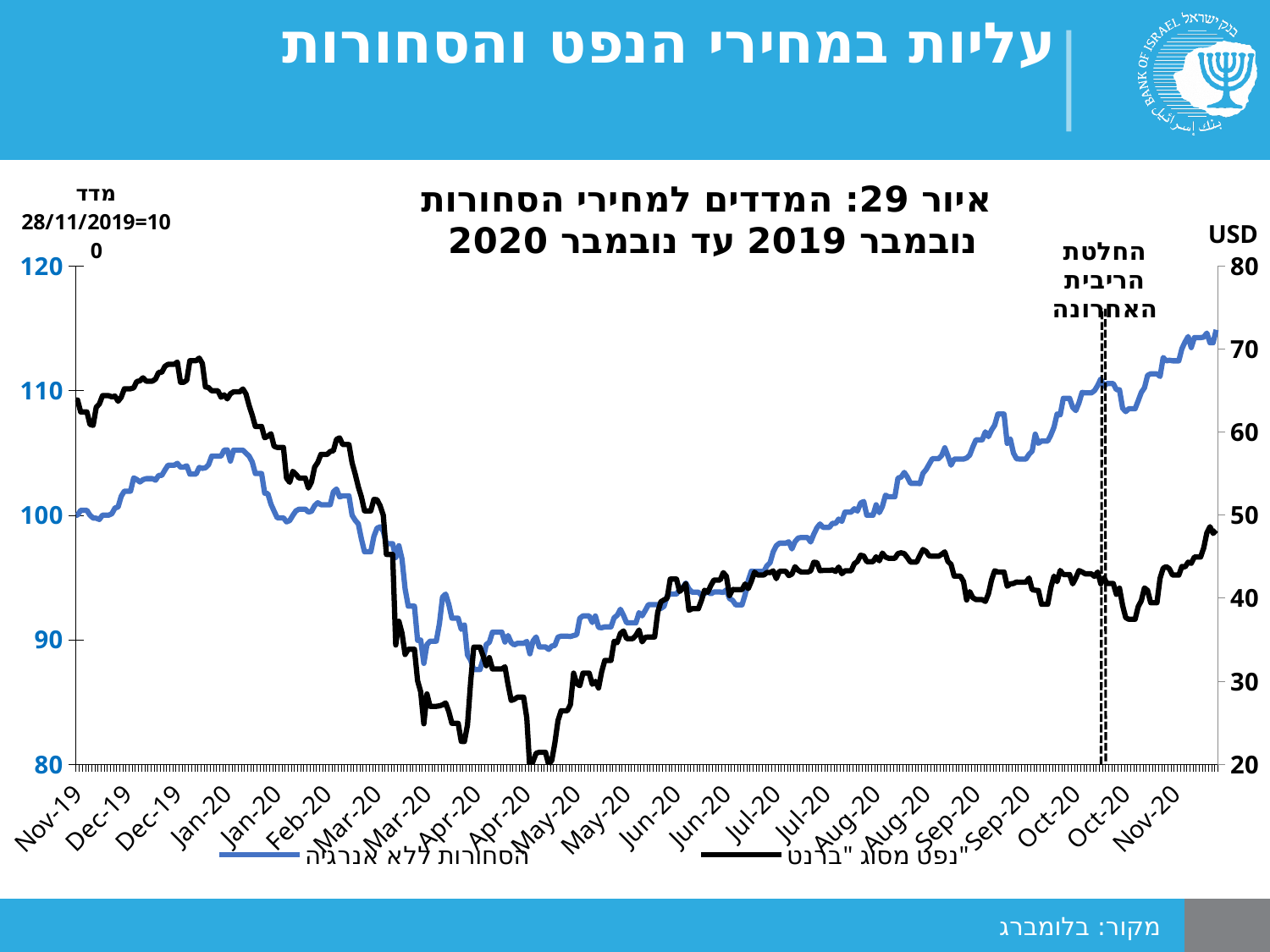
What is the title of the chart? איור 29: המדדים למחירי הסחורות נובמבר 2019 עד נובמבר 2020 Does the blue series (הסחורות ללא אנרגיה) rise or fall between Jun-20 and Nov-20? rise What unit is shown on the right-hand axis of the chart? USD Is the value of the black series (נפט מסוג ברנט) at the start of the chart (Nov-19) greater or less than 60 USD? greater How many series does the legend list? 2 Is the value of the black series (נפט מסוג ברנט) at the end of the chart (Nov-20) greater or less than 40 USD? greater What kind of chart is shown on the slide? line chart Is the value of the blue series (הסחורות ללא אנרגיה) in Jan-20 greater or less than 100? greater Does the black series (נפט מסוג ברנט) rise or fall between Jan-20 and Apr-20? fall